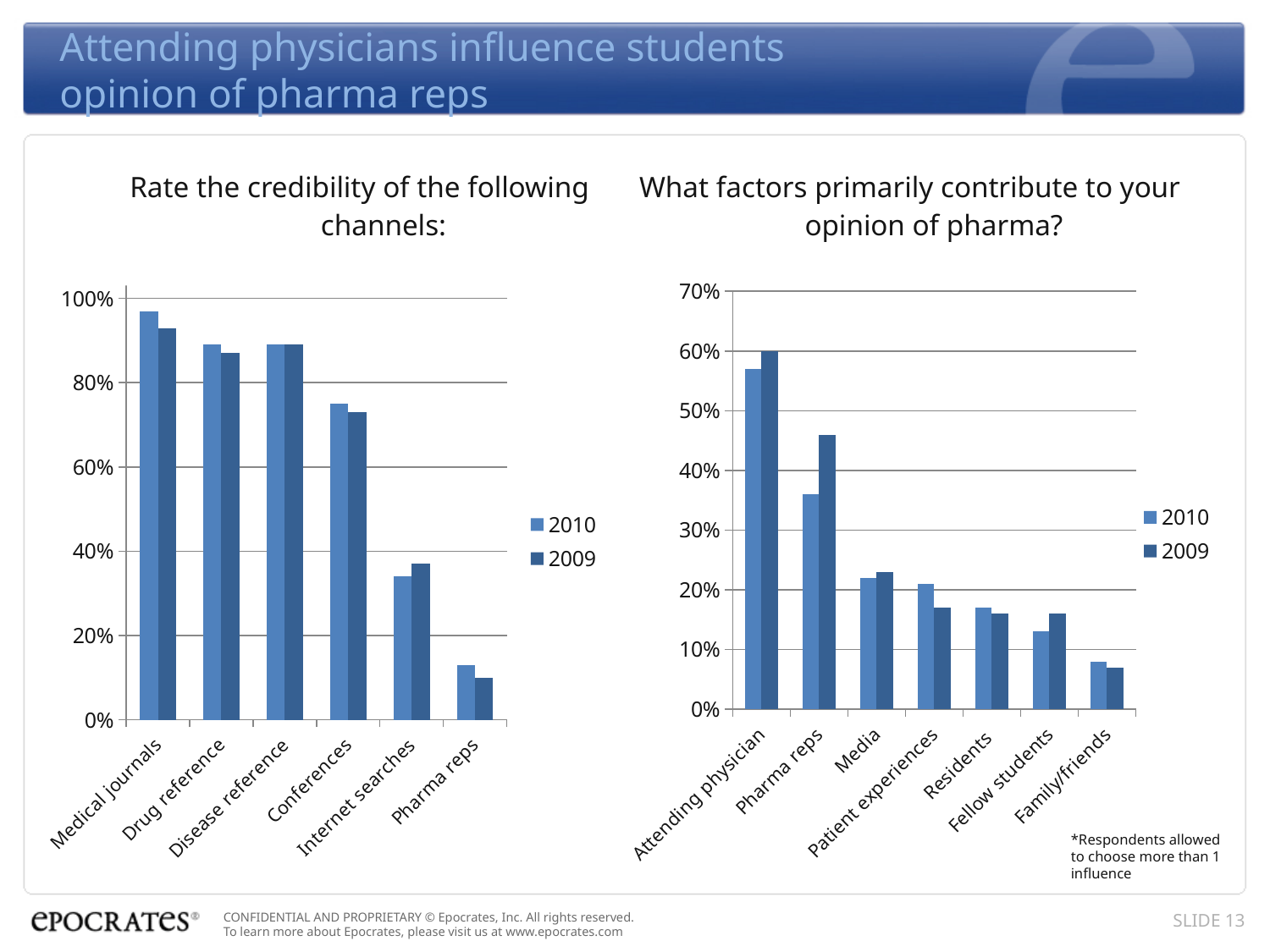
In the 'Rate the credibility of the following channels' chart, how many channels are shown on the x axis? 6 In the 'What factors primarily contribute to your opinion of pharma?' chart, for Pharma reps, which year has the larger value, 2010 or 2009? 2009 What kind of chart is the 'Rate the credibility of the following channels' chart? bar chart In the 'What factors primarily contribute to your opinion of pharma?' chart, how many factors are shown on the x axis? 7 In the 'What factors primarily contribute to your opinion of pharma?' chart, which factor has the highest 2009 value? Attending physician In the 'Rate the credibility of the following channels' chart, which channel has the lowest 2010 value? Pharma reps In the 'Rate the credibility of the following channels' chart, is the 2010 value for Internet searches greater or less than 40%? less In the 'What factors primarily contribute to your opinion of pharma?' chart, is the 2010 value for Attending physician greater or less than 50%? greater In the 'Rate the credibility of the following channels' chart, do the 2010 values generally rise or fall from left to right along the x axis? fall In the 'Rate the credibility of the following channels' chart, which channel has the highest 2010 value? Medical journals In the 'Rate the credibility of the following channels' chart, how many series does the legend list? 2 In the 'Rate the credibility of the following channels' chart, is the 2010 value for Conferences greater or less than 60%? greater